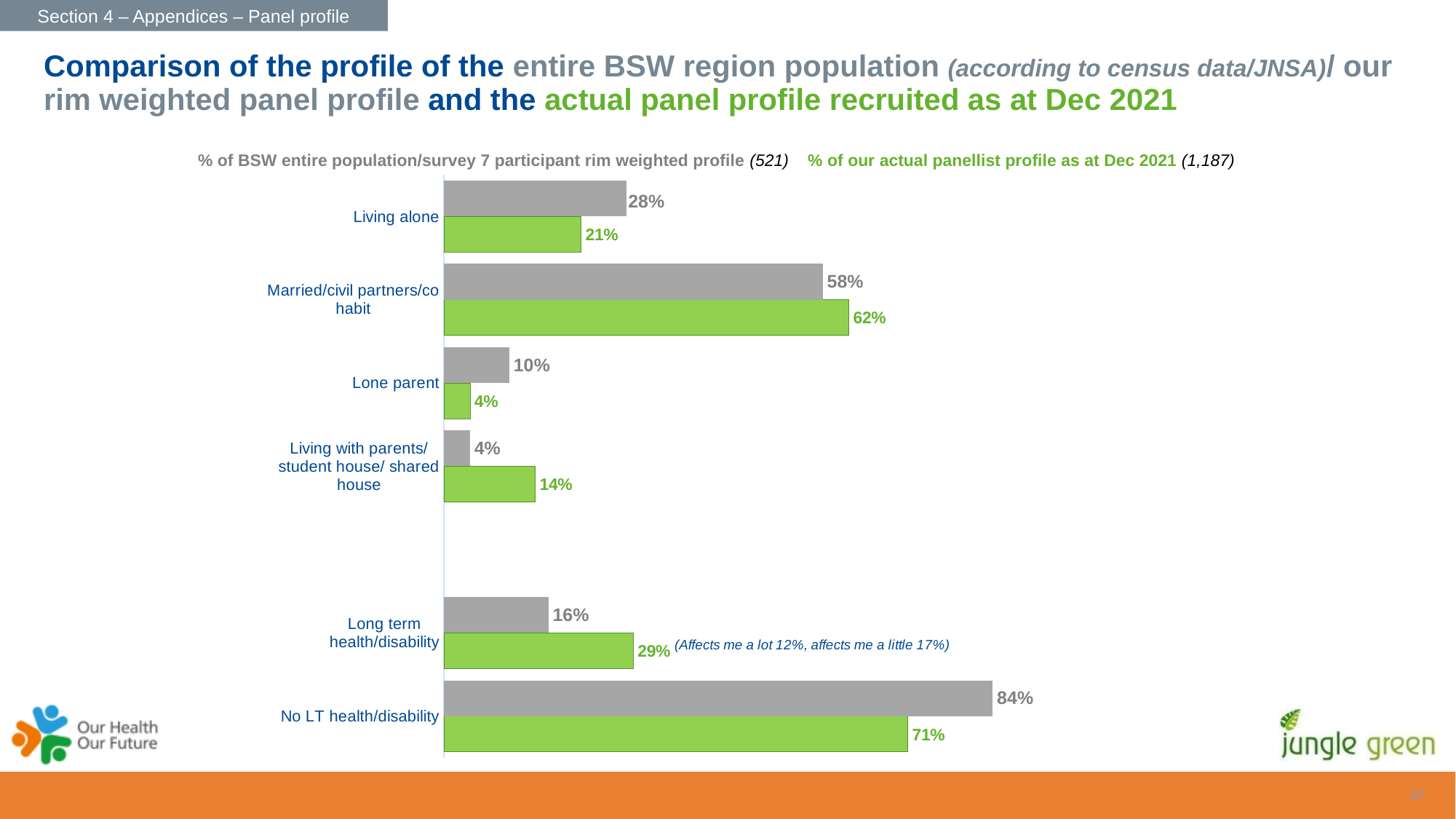
What is the actual panellist profile value for Lone parent? 4% What is the rim weighted profile value for No LT health/disability? 84% Which category has the highest value in the actual panellist profile (green) series? No LT health/disability How many series does the chart show? 2 What is the difference between the rim weighted profile and the actual panellist profile for Long term health/disability? 13% What kind of chart is shown on the slide? bar chart What is the % of BSW entire population/survey 7 participant rim weighted profile for Living alone? 28% For Living with parents/ student house/ shared house, which is larger: the rim weighted profile or the actual panellist profile? the actual panellist profile How many categories are shown on the chart? 6 Which category has the lowest value in the rim weighted profile (grey) series? Living with parents/ student house/ shared house What is the % of our actual panellist profile as at Dec 2021 for Married/civil partners/co habit? 62% What is the sample size shown for the actual panellist profile as at Dec 2021? 1,187